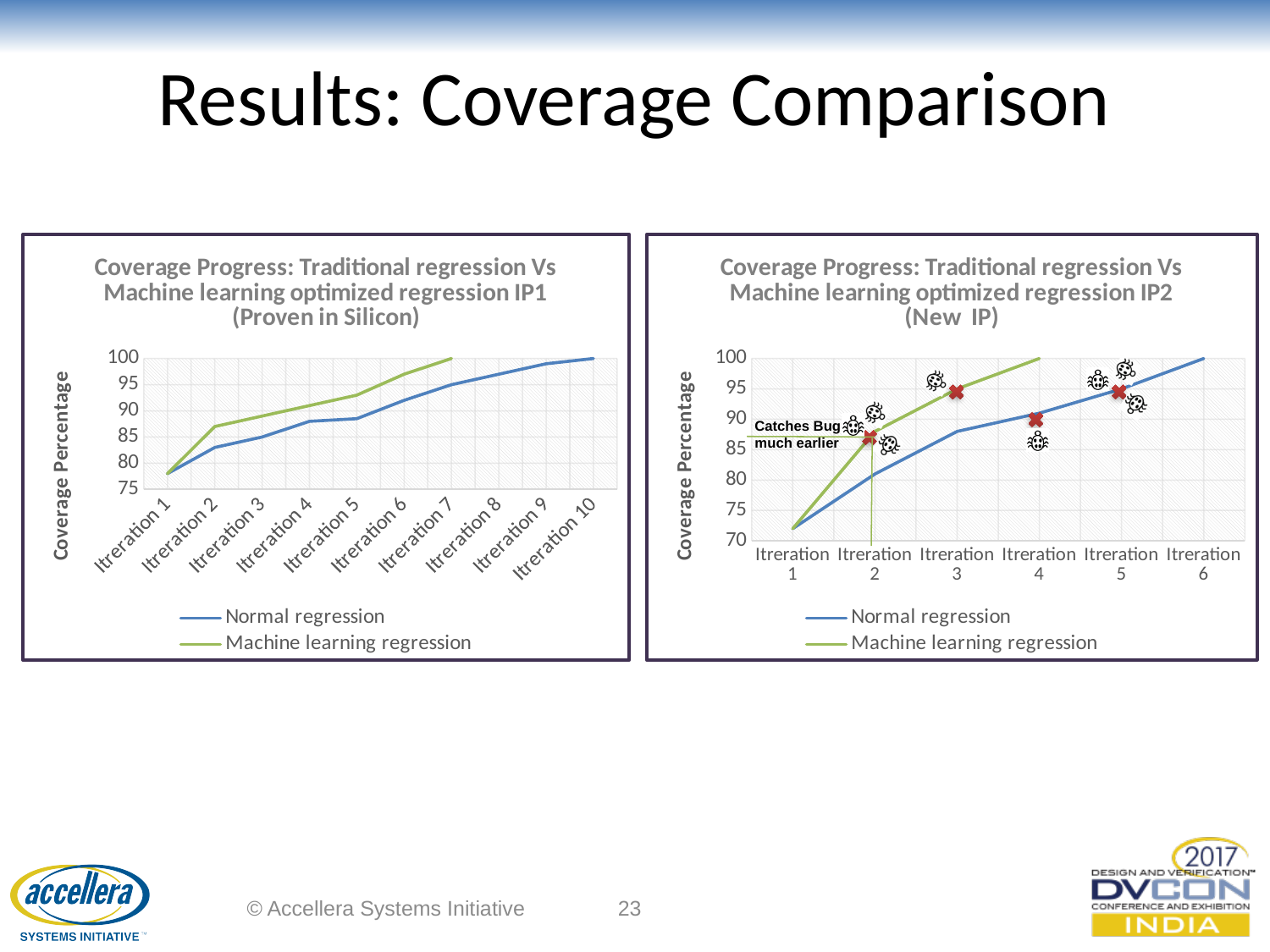
In the left chart (IP1), is the value for Normal regression at Itreration 1 greater or less than 80? less What is the y-axis title of the left chart (IP1)? Coverage Percentage How many iterations are shown on the x axis of the left chart (IP1)? 10 How many iterations are shown on the x axis of the right chart (IP2, New IP)? 6 In the right chart (IP2), is the value for Normal regression at Itreration 1 greater or less than 75? less What annotation text is shown near Itreration 2 in the right chart (IP2)? Catches Bug much earlier How many series does the legend of the right chart (IP2) list? 2 In the left chart (IP1), which series has the higher value at Itreration 6, Normal regression or Machine learning regression? Machine learning regression In the right chart (IP2), is the value for Machine learning regression at Itreration 3 greater or less than 90? greater In the right chart (IP2), does the Normal regression line rise or fall from Itreration 1 to Itreration 6? Rise What type of chart is the left chart (IP1, Proven in Silicon)? Line chart